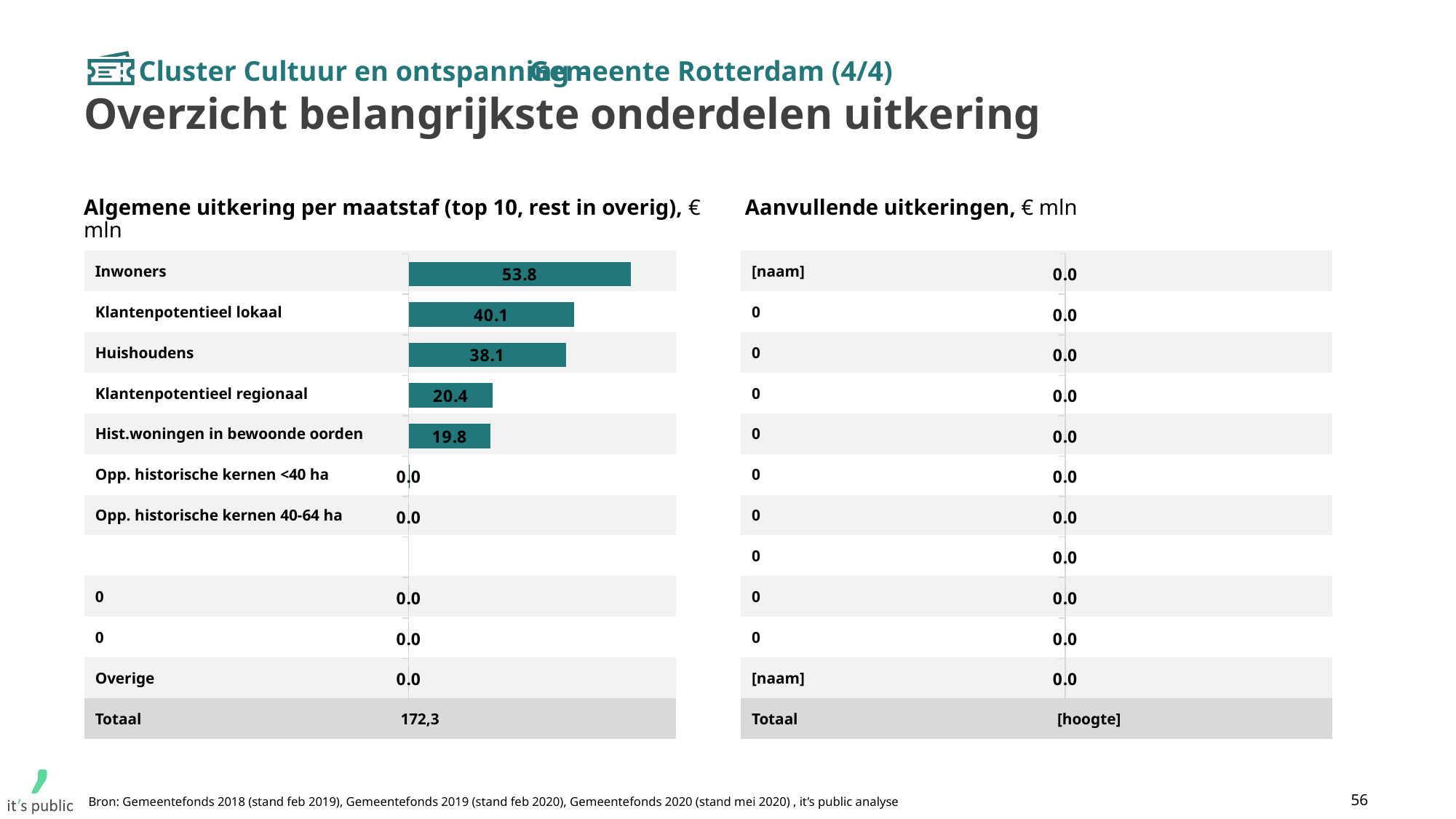
In the 'Algemene uitkering per maatstaf' chart, what is the value for Huishoudens? 38.1 What is the title of the chart on the right side of the slide? Aanvullende uitkeringen, € mln In the 'Algemene uitkering per maatstaf' chart, what is the value for Overige? 0.0 In the 'Algemene uitkering per maatstaf' chart, which is larger: Huishoudens or Klantenpotentieel regionaal? Huishoudens What kind of chart is the 'Algemene uitkering per maatstaf' chart on the left? bar chart In the 'Algemene uitkering per maatstaf' chart, which category has the highest value? Inwoners In the 'Algemene uitkering per maatstaf' chart, what is the Totaal shown at the bottom? 172,3 In the 'Algemene uitkering per maatstaf' chart, what is the value for Inwoners? 53.8 In the 'Algemene uitkering per maatstaf' chart, what is the difference between Klantenpotentieel lokaal and Huishoudens? 2.0 In the 'Algemene uitkering per maatstaf' chart, what is the value for Hist.woningen in bewoonde oorden? 19.8 In the 'Algemene uitkering per maatstaf' chart, what is the value for Klantenpotentieel regionaal? 20.4 In the 'Algemene uitkering per maatstaf' chart, what is the difference between Inwoners and Klantenpotentieel lokaal? 13.7